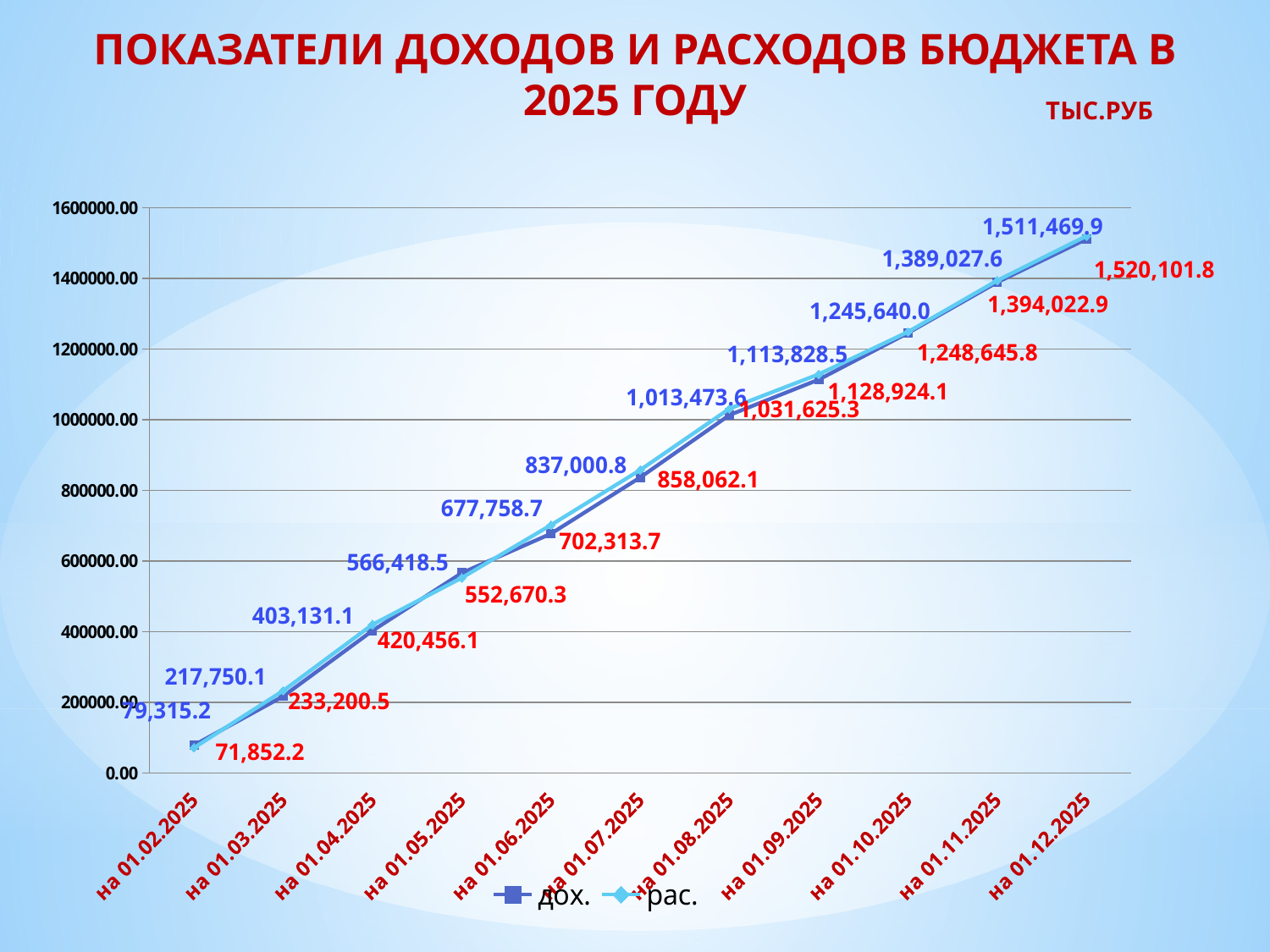
How many dates are plotted along the x axis? 11 What is the value of the рас. series at на 01.12.2025? 1,520,101.8 Is the value of the дох. series at на 01.09.2025 greater or less than 1000000.00? greater Which series has the larger value at на 01.05.2025, дох. or рас.? дох. What is the difference between the рас. and дох. values at на 01.12.2025? 8,631.9 How many series does the legend list? 2 At which date is the рас. series at its lowest value? на 01.02.2025 What is the value of the дох. series at на 01.07.2025? 837,000.8 What is the value of the рас. series at на 01.04.2025? 420,456.1 At which date does the дох. series reach its highest value? на 01.12.2025 What kind of chart is shown on the slide? line chart What is the value of the дох. series at на 01.02.2025? 79,315.2